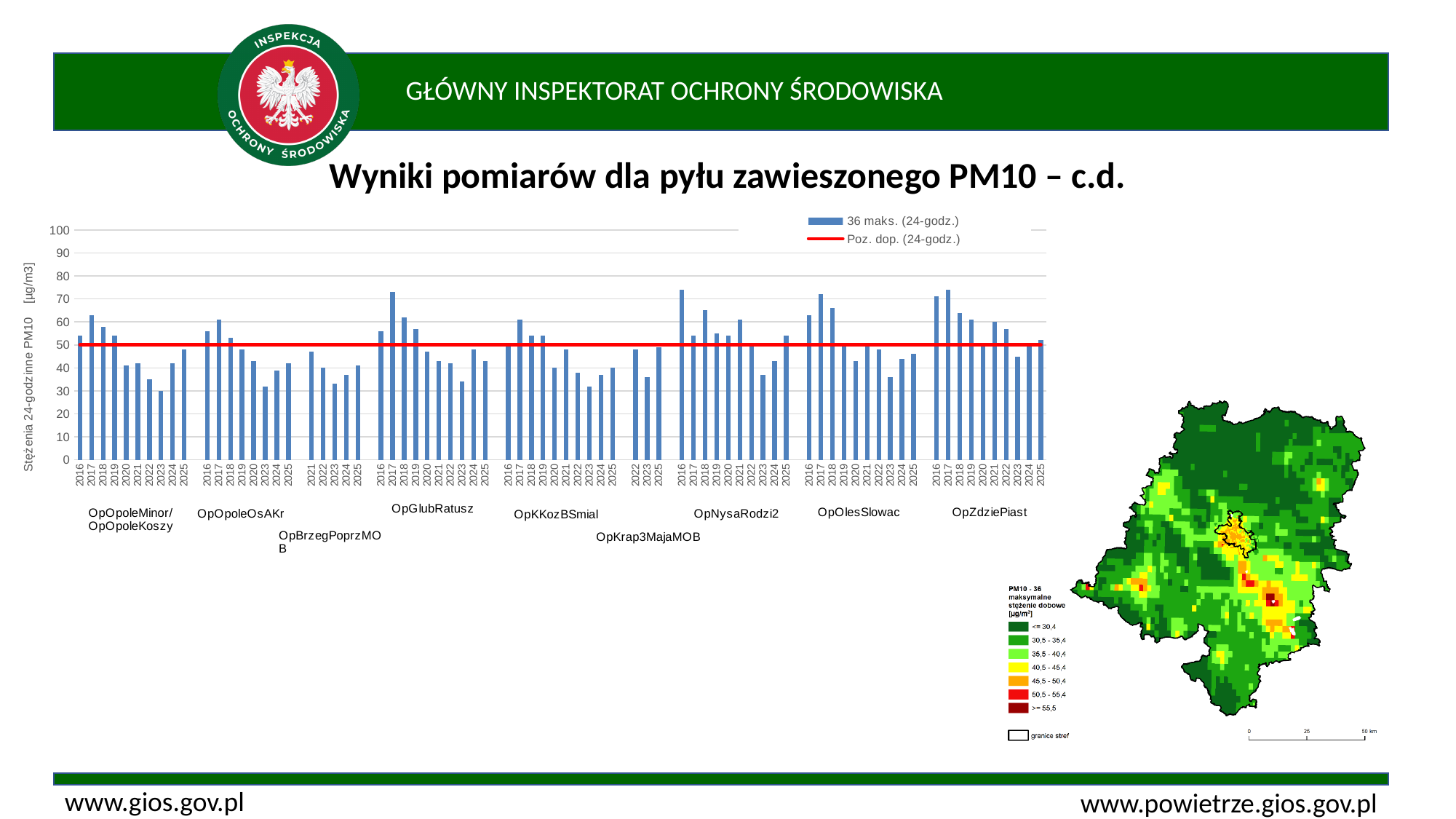
Is the value for OpGlubRatusz in 2017 greater or less than 60? greater What is the label of the y axis? Stężenia 24-godzinne PM10 [µg/m3] At what value on the y axis is the red Poz. dop. (24-godz.) line drawn? 50 How many series does the chart legend list? 2 Do the values for OpGlubRatusz rise or fall from 2017 to 2023? fall Which is larger for OpGlubRatusz: the value for 2017 or the value for 2023? 2017 Is the value for OpNysaRodzi2 in 2016 greater or less than 60? greater Is the value for OpKrap3MajaMOB in 2023 greater or less than 40? less What are the two entries in the chart legend? 36 maks. (24-godz.) and Poz. dop. (24-godz.) What is the first year shown on the x axis of the chart? 2016 What kind of chart is shown on the slide? bar chart